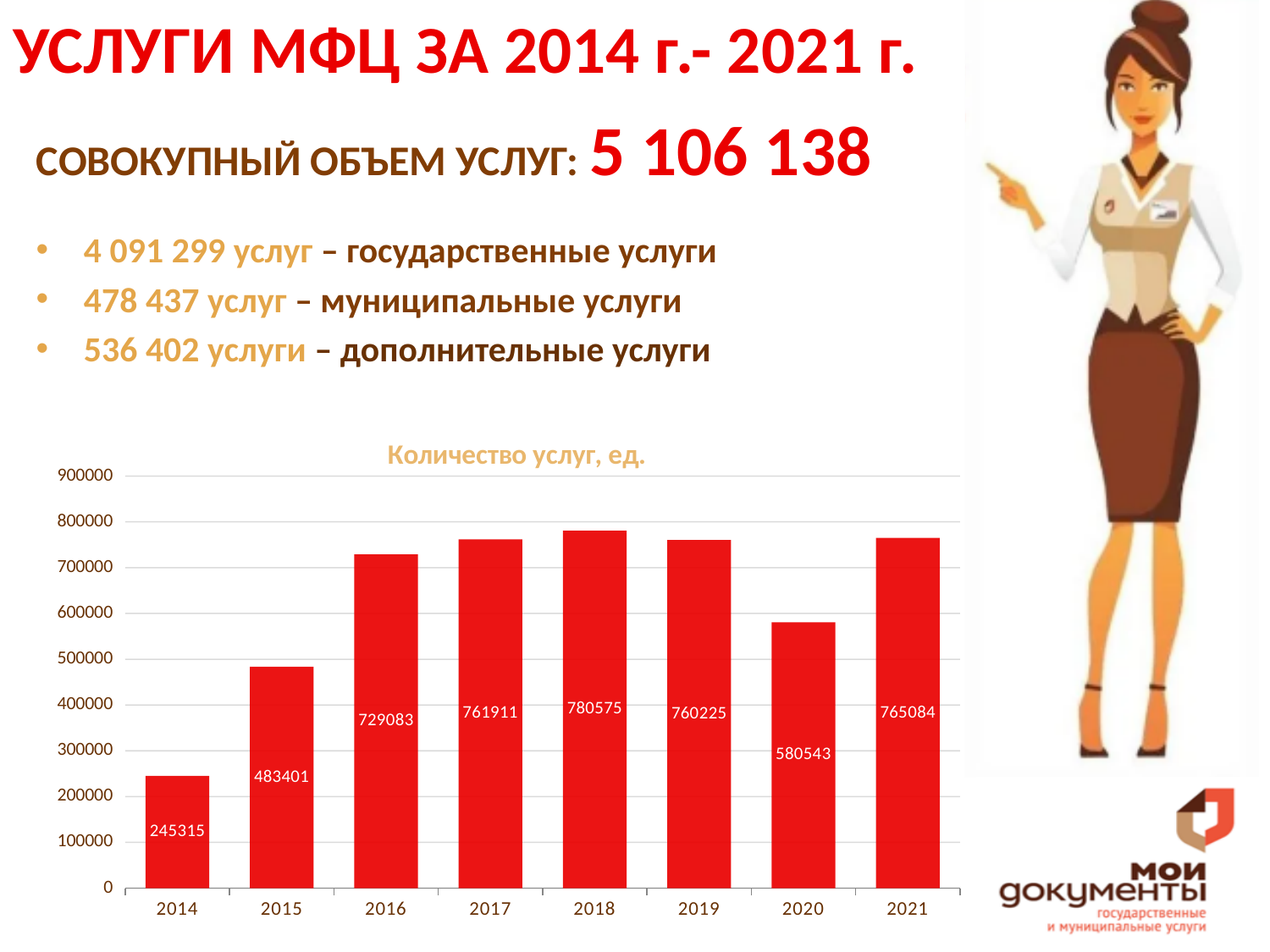
What is the title of the chart? Количество услуг, ед. Which is larger, the value for 2016 or the value for 2020? 2016 What is the value for 2021 in the chart? 765084 What kind of chart is shown on the slide? bar chart What is the difference between the values for 2015 and 2014? 238086 Is the value for 2020 greater or less than 600000? less How many years are shown on the x axis of the chart? 8 Which year has the lowest value in the chart? 2014 What is the value for 2014 in the chart? 245315 What is the value for 2020 in the chart? 580543 Which year has the highest value in the chart? 2018 What is the difference between the values for 2021 and 2020? 184541